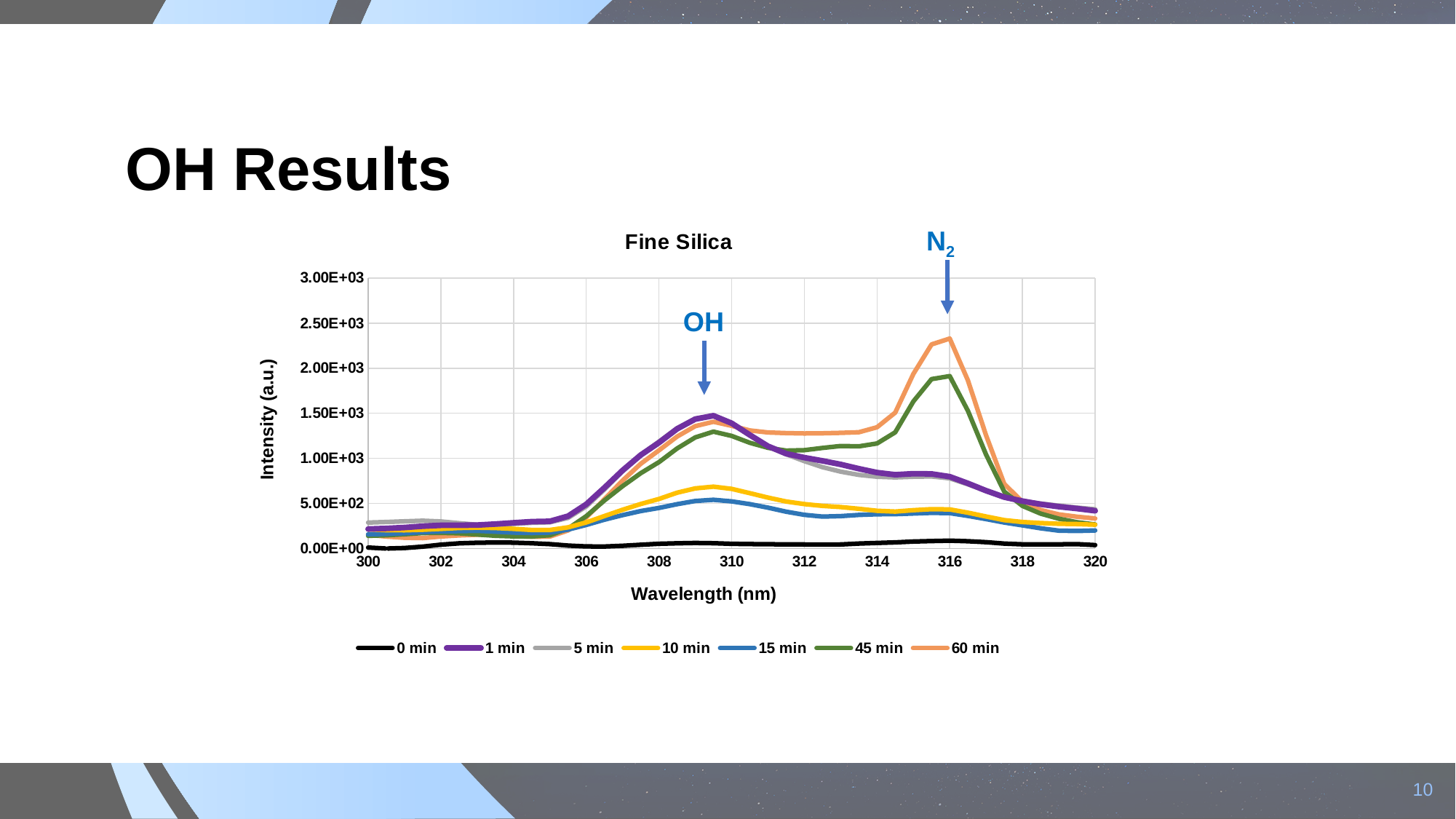
Is the peak value of the 45 min series near 316 nm greater or less than 2.00E+03? less Is the peak value of the 1 min series near 309 nm greater or less than 1.00E+03? greater Is the 0 min series ever greater or less than 5.00E+02 across the chart? less Does the 1 min series rise or fall between 310 nm and 320 nm? Fall Which series reaches the highest intensity anywhere on the Fine Silica chart? 60 min What is the label of the x axis of the Fine Silica chart? Wavelength (nm) What kind of chart is shown on the slide? Line chart How many series does the legend of the Fine Silica chart list? 7 Which series stays lowest across the whole wavelength range on the Fine Silica chart? 0 min At 316 nm, which series has the higher intensity, 60 min or 45 min? 60 min What is the title of the chart? Fine Silica